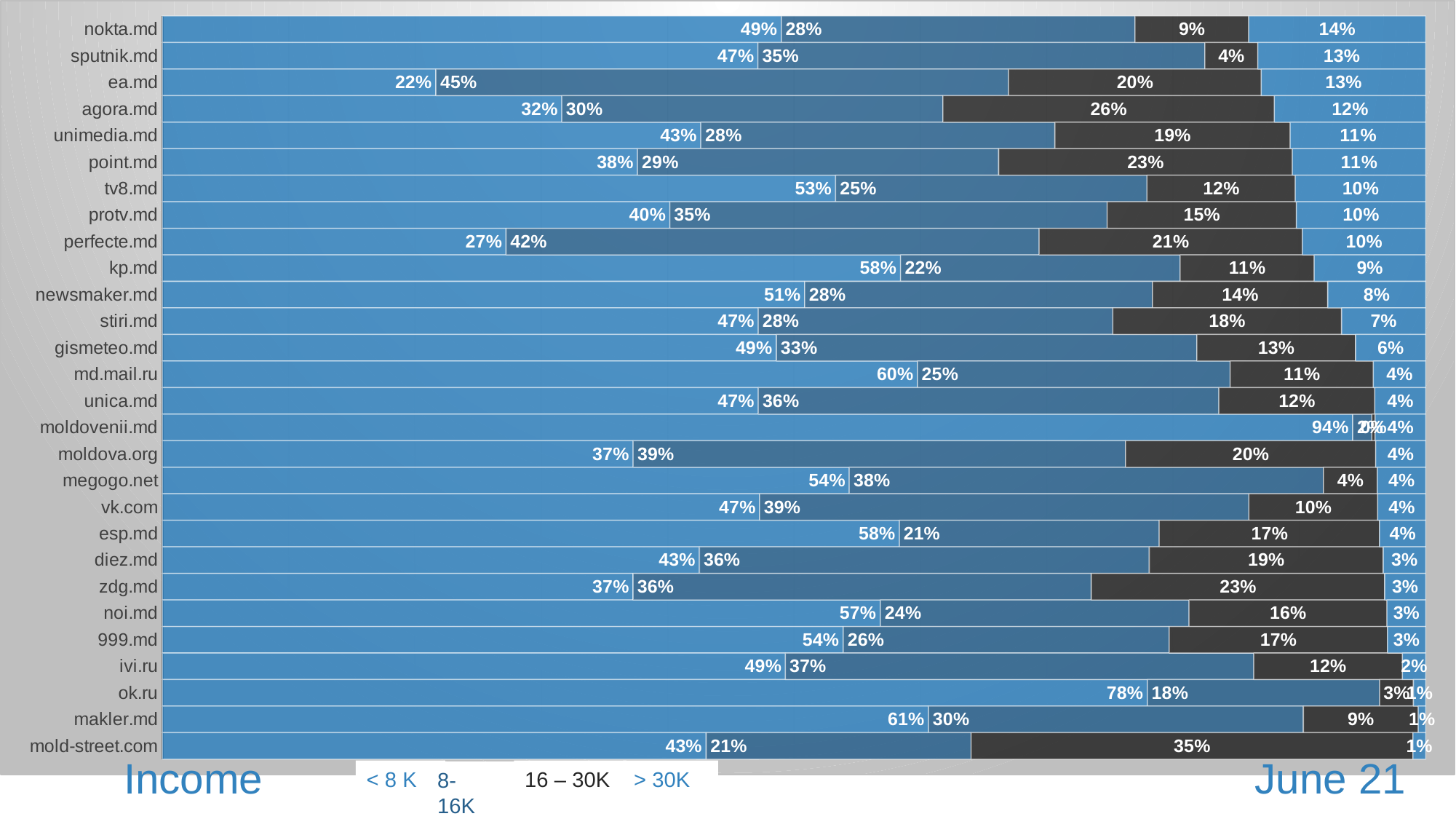
Which site has the highest > 30K share? nokta.md How many income groups does the legend list? 4 What percentage of nokta.md's audience falls in the < 8 K income group? 49% Which site has the highest < 8 K share? moldovenii.md What type of chart is shown? Stacked bar chart What is the difference between the 16 – 30K values of agora.md and ea.md? 6% Which site has the highest 16 – 30K share? mold-street.com What is the > 30K value for ea.md? 13% How many sites are listed on the chart? 28 Which has a larger 16 – 30K share, agora.md or point.md? agora.md What is the 16 – 30K value for mold-street.com? 35% What is the 8-16K value for perfecte.md? 42%